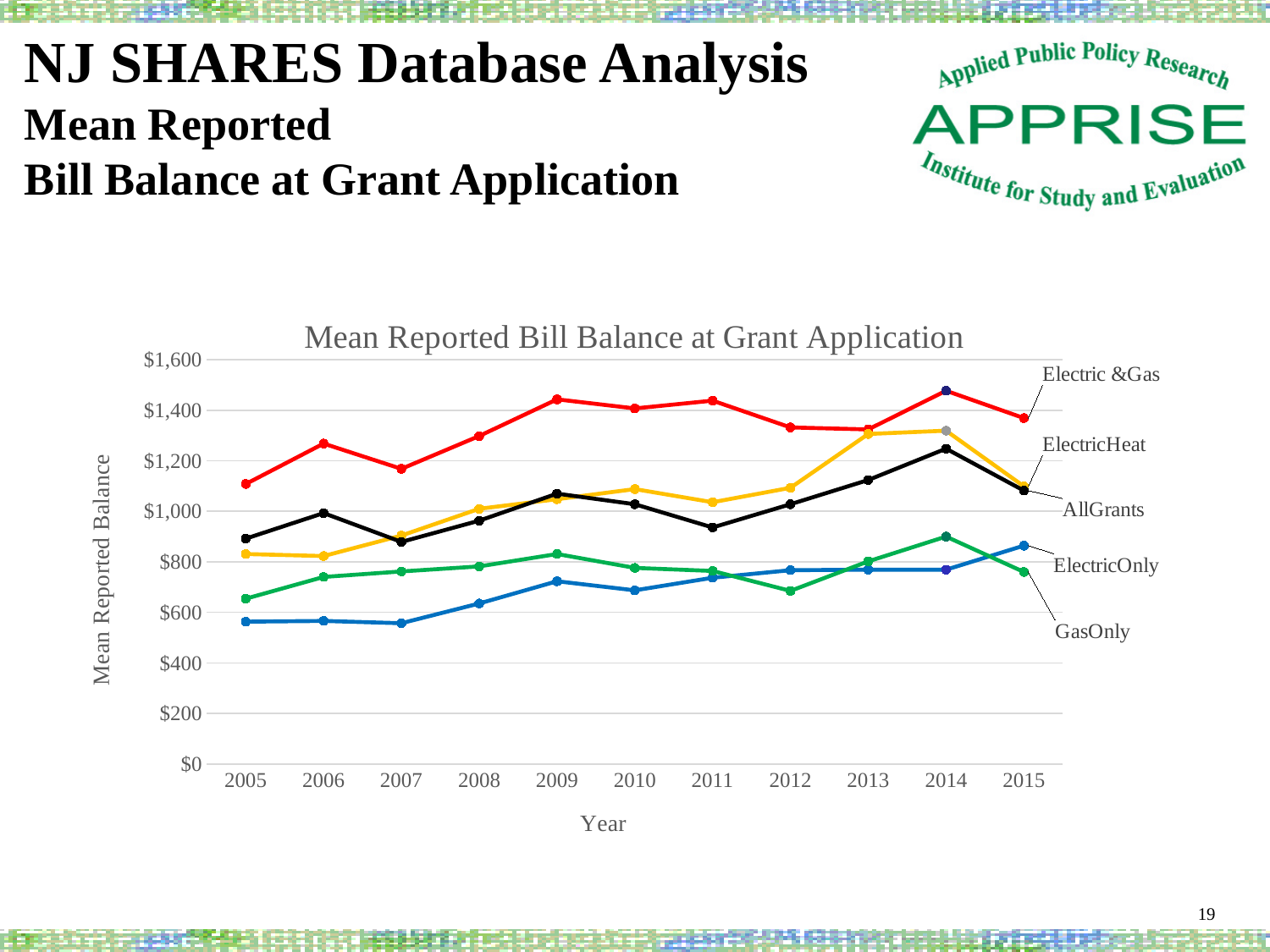
What kind of chart is shown on the slide? line chart Is the value for Electric &Gas in 2014 greater or less than $1,400? greater What is the label on the y axis of the chart? Mean Reported Balance In which year does the Electric &Gas series reach its highest value? 2014 Which series has the lowest mean reported balance in 2005? ElectricOnly Is the value for ElectricHeat in 2013 greater or less than $1,200? greater In 2015, which is larger: the value for ElectricOnly or the value for GasOnly? ElectricOnly Which series has the highest mean reported balance in 2005? Electric &Gas Does the GasOnly series generally rise or fall from 2005 to 2015? rise How many years are plotted along the x axis? 11 Is the value for GasOnly in 2007 greater or less than $600? greater How many series are labelled on the chart? 5